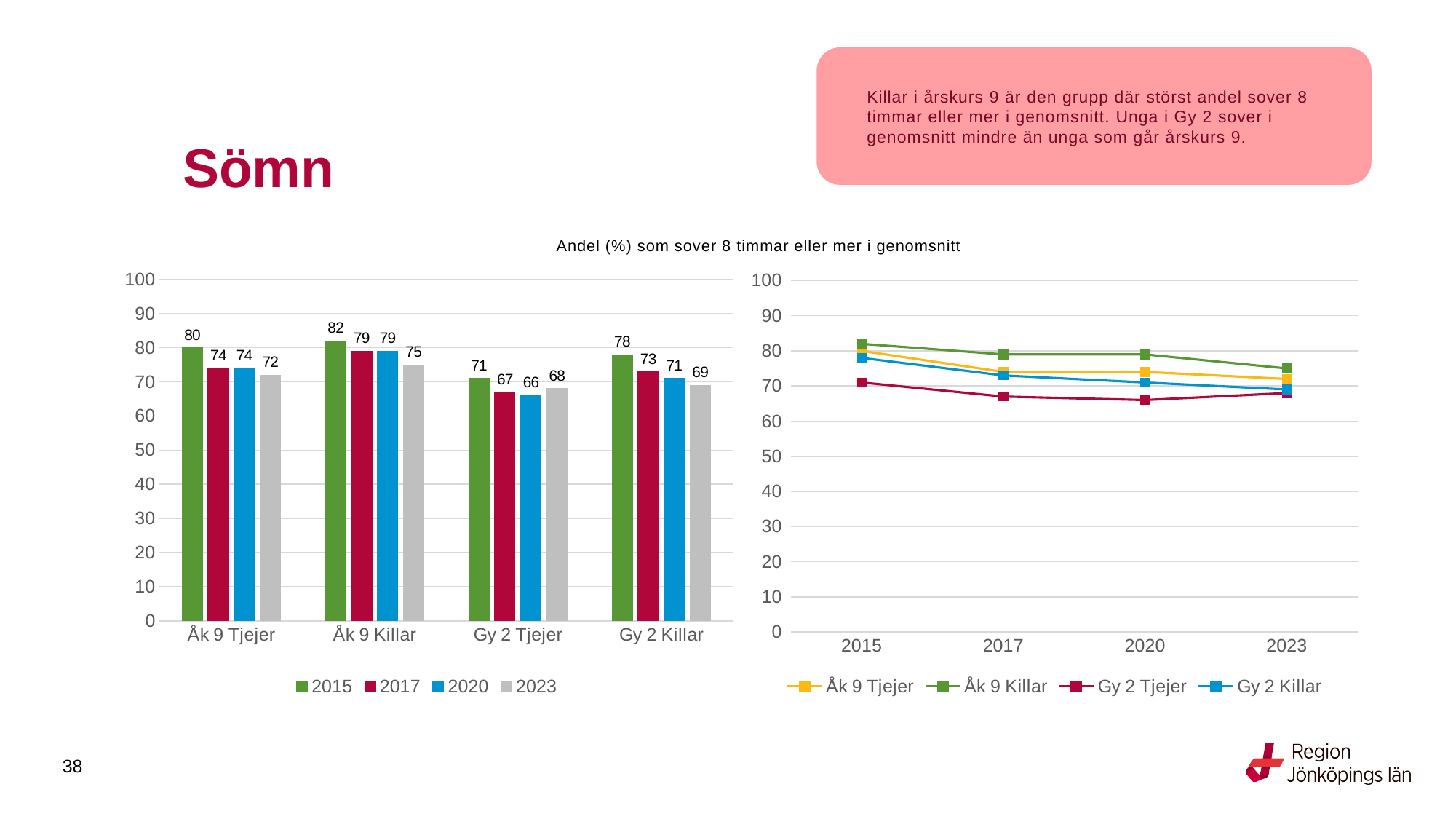
In the bar chart on the left, which category has the lowest value for 2023? Gy 2 Tjejer In the bar chart on the left, which is larger for Gy 2 Killar: the 2017 value or the 2020 value? 2017 In the bar chart on the left, what is the value for Gy 2 Killar in 2023? 69 In the bar chart on the left, which category has the highest value for 2015? Åk 9 Killar In the bar chart on the left, how many categories are shown on the x axis? 4 In the line chart on the right, is the value for Gy 2 Tjejer in 2020 greater or less than 70? less In the bar chart on the left, what is the difference between the 2015 and 2023 values for Åk 9 Tjejer? 8 In the bar chart on the left, what is the value for Gy 2 Tjejer in 2020? 66 In the line chart on the right, does the Åk 9 Killar line rise or fall from 2015 to 2023? fall What kind of chart is the chart on the right? line chart In the bar chart on the left, what is the value for Åk 9 Killar in 2015? 82 In the line chart on the right, how many series does the legend list? 4